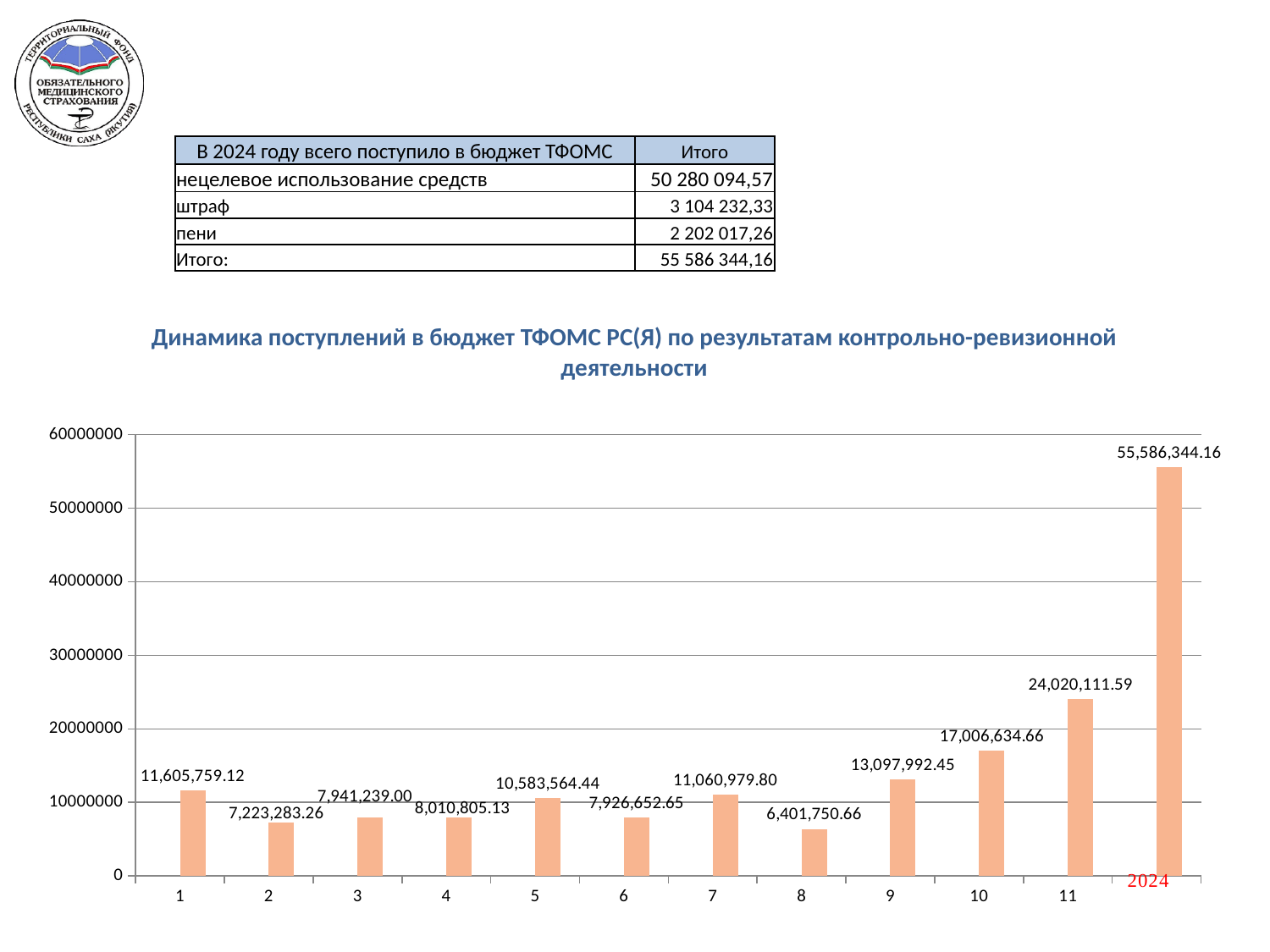
Is the value for category 11 greater or less than 20000000? greater What type of chart is shown on the slide? bar chart Which category has the lowest value in the chart? 8 What is the difference between the values for category 10 and category 9? 3,908,642.21 What is the value for category 8 in the chart? 6,401,750.66 What is the value for category 10 in the chart? 17,006,634.66 What is the value for the bar labelled 2024? 55,586,344.16 How many bars are plotted in the chart? 12 Which category has the highest value in the chart? 2024 Which is larger, the value for category 5 or the value for category 9? category 9 What is the difference between the value for 2024 and the value for category 11? 31,566,232.57 What is the value for category 1 in the chart? 11,605,759.12